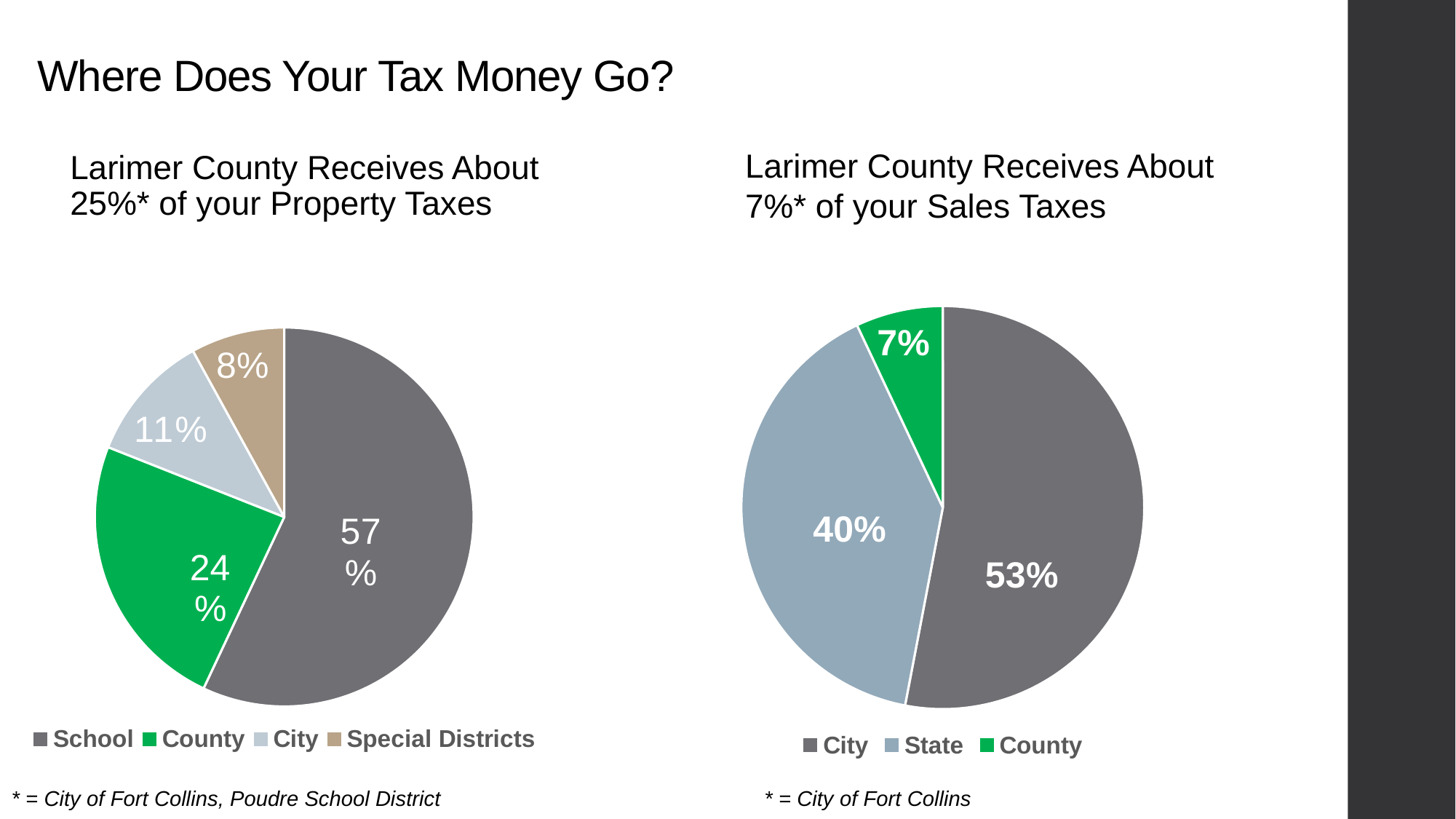
In the property taxes pie chart on the left, what is the difference between the School share and the County share? 33% In the property taxes pie chart on the left, what share goes to School? 57% In the sales taxes pie chart on the right, which category receives the largest share? City In the sales taxes pie chart on the right, which is larger: the share for City or the share for State? City In the sales taxes pie chart on the right, what is the difference between the City share and the County share? 46% In the property taxes pie chart on the left, which category receives the smallest share? Special Districts In the property taxes pie chart on the left, how many categories are shown? 4 In the property taxes pie chart on the left, what colour represents County? Green What type of chart is used on the left side of the slide? Pie chart In the sales taxes pie chart on the right, how many categories does the legend list? 3 In the property taxes pie chart on the left, what share goes to Special Districts? 8% In the sales taxes pie chart on the right, what share goes to State? 40%